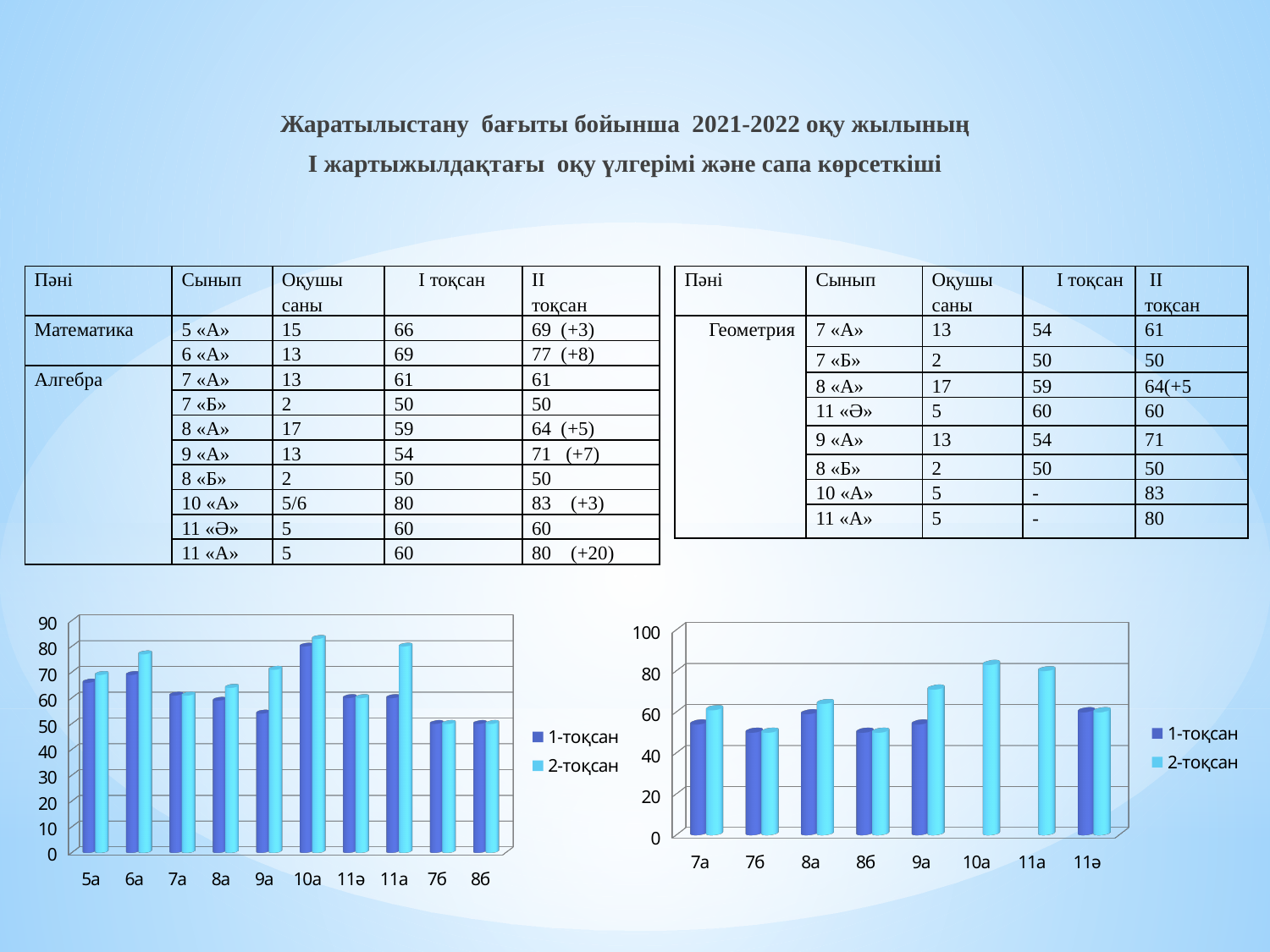
In the left chart, which category has the highest 2-тоқсан bar? 10а In the left chart, which is larger for 11а: the 1-тоқсан bar or the 2-тоқсан bar? 2-тоқсан In the right chart, is the 2-тоқсан value for 9а greater or less than 60? greater How many categories are shown on the x axis of the right chart? 8 How many series does the legend of the left chart list? 2 How many categories are shown on the x axis of the left chart? 10 In the left chart, what is the 1-тоқсан value for 11ә? 60 In the left chart, is the 2-тоқсан value for 6а greater or less than 70? greater In the right chart, which two categories have no 1-тоқсан bar? 10а and 11а In the right chart, which is larger for 9а: the 1-тоқсан bar or the 2-тоқсан bar? 2-тоқсан In the left chart, is the 1-тоқсан value for 10а greater or less than 70? greater What kind of chart is the chart on the left of the slide? bar chart